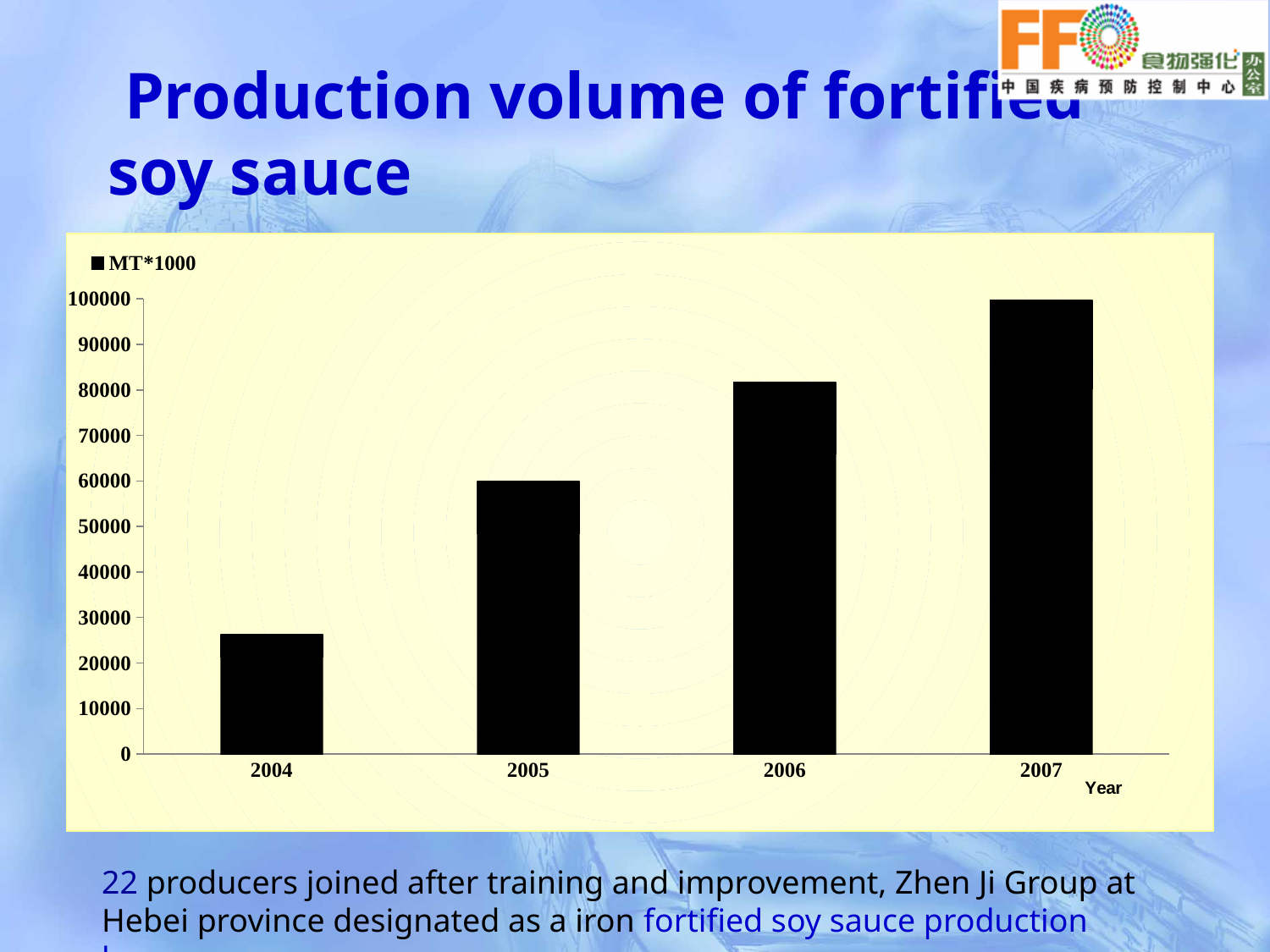
What kind of chart is shown on the slide? bar chart Which year has the lowest production volume in the chart? 2004 Is the value for 2004 greater or less than 30000? less What is the legend entry for the series in the chart? MT*1000 How many series does the chart legend list? 1 Which year has the highest production volume in the chart? 2007 Is the value for 2007 greater or less than 90000? greater Do the values rise or fall from 2004 to 2007? rise Which is larger, the value for 2005 or the value for 2006? 2006 Is the value for 2005 greater or less than 50000? greater How many years are shown on the x axis of the chart? 4